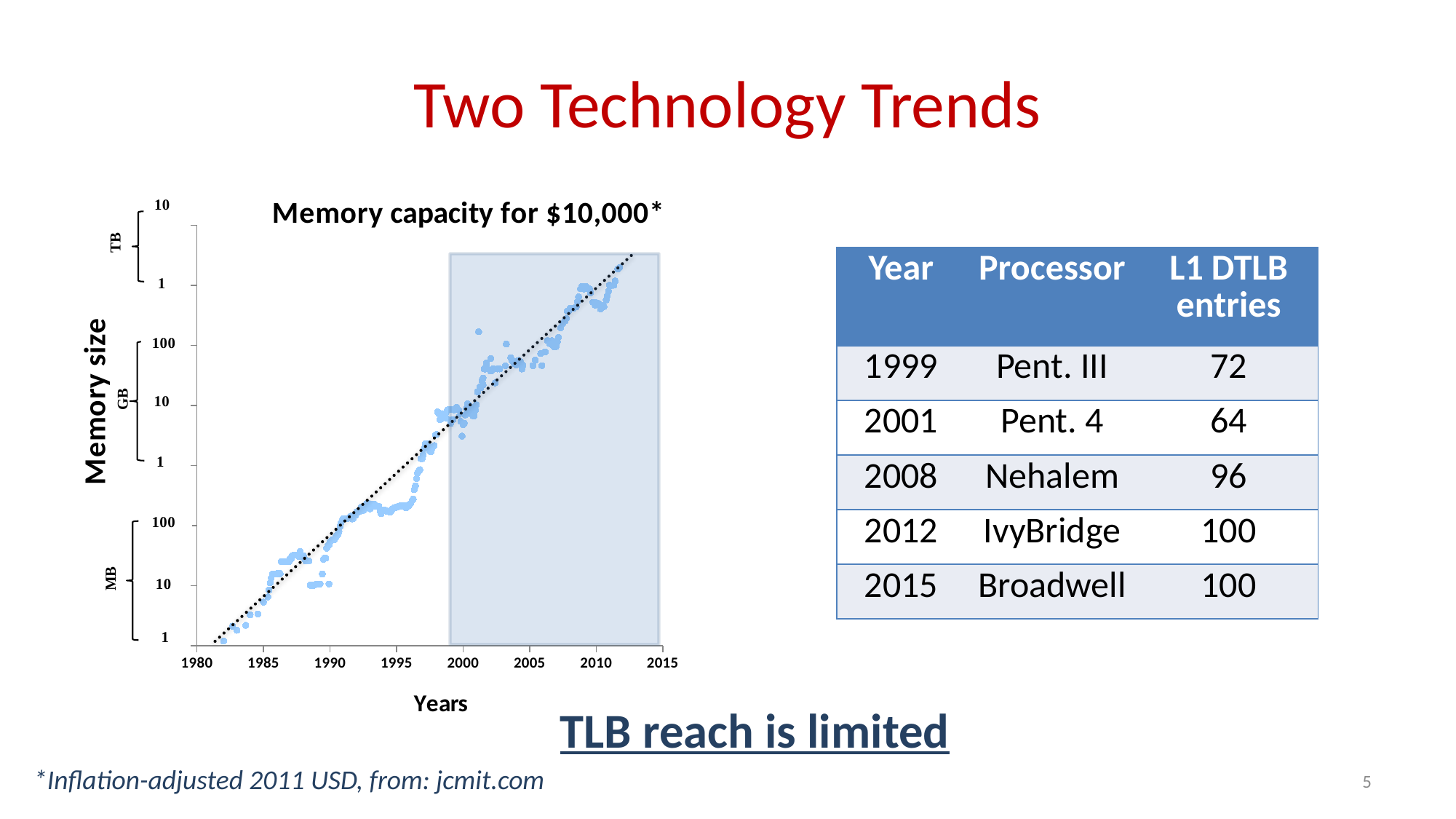
In the "Memory capacity for $10,000*" chart, does memory capacity rise or fall as the years increase? Rise In the "Memory capacity for $10,000*" chart, is the memory capacity around 1995 greater or less than 100 MB? greater In the "Memory capacity for $10,000*" chart, is the memory capacity around 1990 greater or less than 1 GB? less In the "Memory capacity for $10,000*" chart, is the memory capacity around 2010 greater or less than 100 GB? greater How many year tick labels are shown on the x axis of the "Memory capacity for $10,000*" chart? 8 What kind of chart is the "Memory capacity for $10,000*" chart? Scatter chart What is the first year shown on the x axis of the "Memory capacity for $10,000*" chart? 1980 What is the label of the x axis of the "Memory capacity for $10,000*" chart? Years What is the last year shown on the x axis of the "Memory capacity for $10,000*" chart? 2015 What is the title of the chart on the left of the slide? Memory capacity for $10,000*